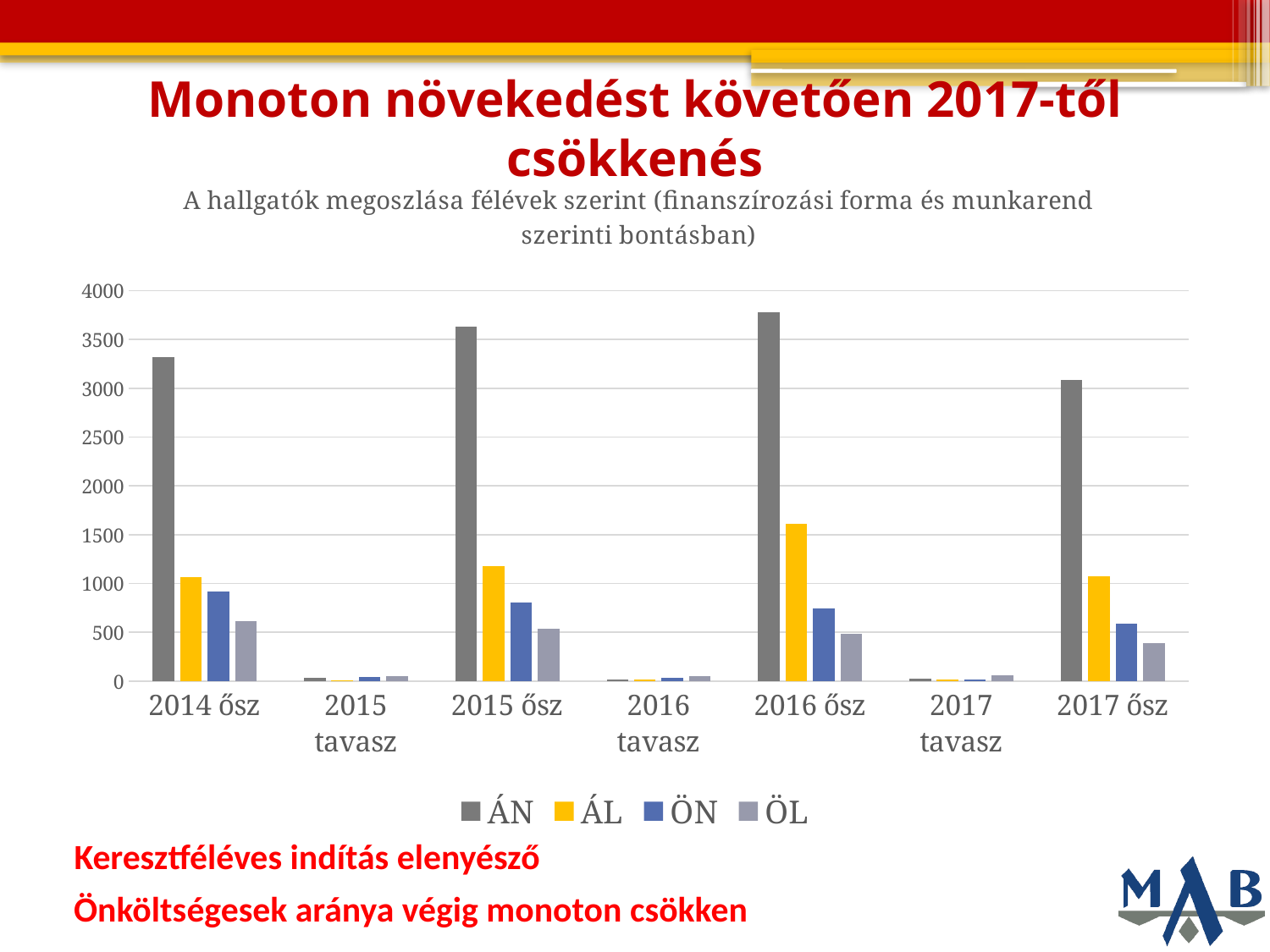
Is the ÁL value for 2016 ősz greater or less than 1500? greater Do the ÖN values rise or fall across the autumn (ősz) semesters from 2014 to 2017? fall Which series has the highest value in 2016 ősz? ÁN Is the ÖL value for 2017 ősz greater or less than 500? less In which semester is the ÁN value highest? 2016 ősz Is the ÁN value for 2014 ősz greater or less than 3000? greater What colour represents the ÁL series in the legend? yellow How many semester categories are shown on the x axis? 7 Which is larger, the ÁN value for 2016 ősz or the ÁN value for 2014 ősz? 2016 ősz What kind of chart is shown on the slide? bar chart How many series does the legend list? 4